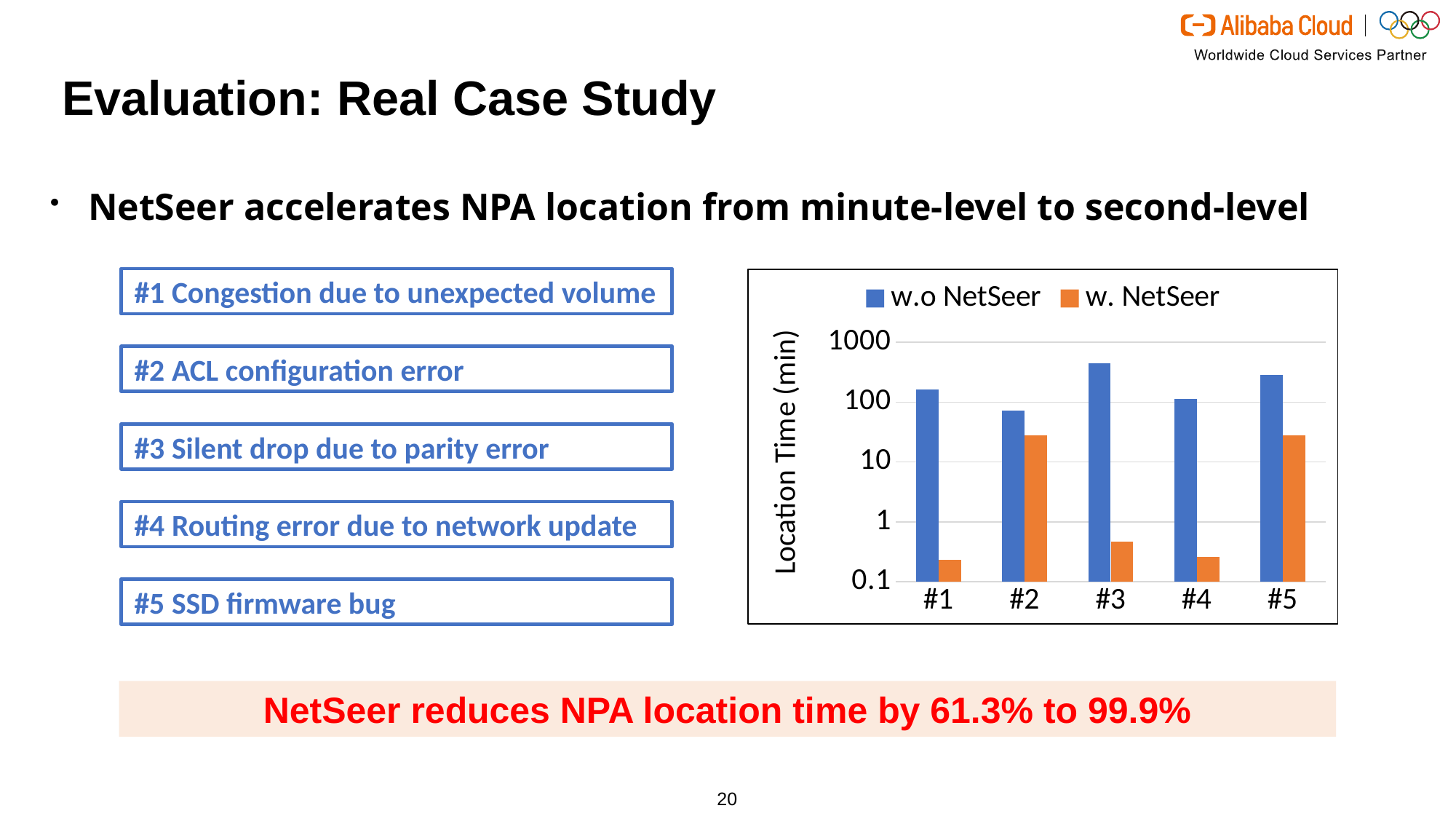
Is the w.o NetSeer value for #2 greater or less than 100? less How many cases (categories) are shown on the x axis of the chart? 5 What is the y-axis label of the chart? Location Time (min) Which series in the chart is shown in orange? w. NetSeer Which case has the highest location time for w.o NetSeer? #3 Which case has the lowest location time for w.o NetSeer? #2 Is the w. NetSeer value for #1 greater or less than 1? less Is the w. NetSeer value for #2 greater or less than 10? greater For case #3, which is larger: the w.o NetSeer value or the w. NetSeer value? w.o NetSeer How many series does the chart legend list? 2 What kind of chart is shown on the slide? bar chart